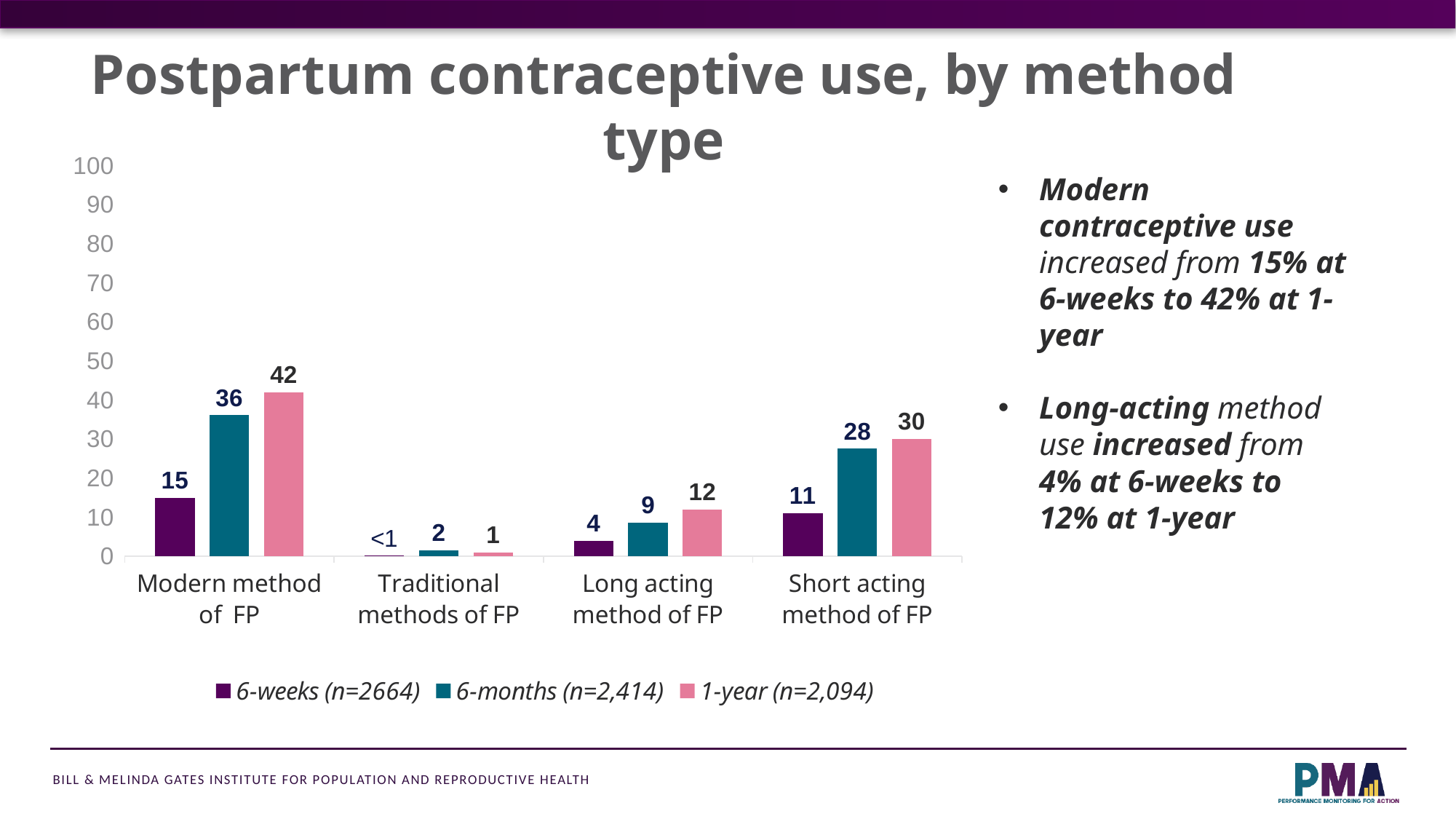
What is the value for Modern method of FP in the 1-year series? 42 How many categories are shown on the x axis? 4 Which is larger for Short acting method of FP: the 6-months value or the 1-year value? 1-year What is the value for Short acting method of FP in the 6-months series? 28 What is the value for Traditional methods of FP in the 6-weeks series? <1 Which category has the lowest value in the 6-months series? Traditional methods of FP Which category has the highest value in the 1-year series? Modern method of FP What kind of chart is shown on the slide? Bar chart How many series does the legend list? 3 What is the sample size shown in the legend for the 6-months series? n=2,414 What is the difference between the 1-year and 6-weeks values for Modern method of FP? 27 What is the value for Long acting method of FP in the 6-weeks series? 4